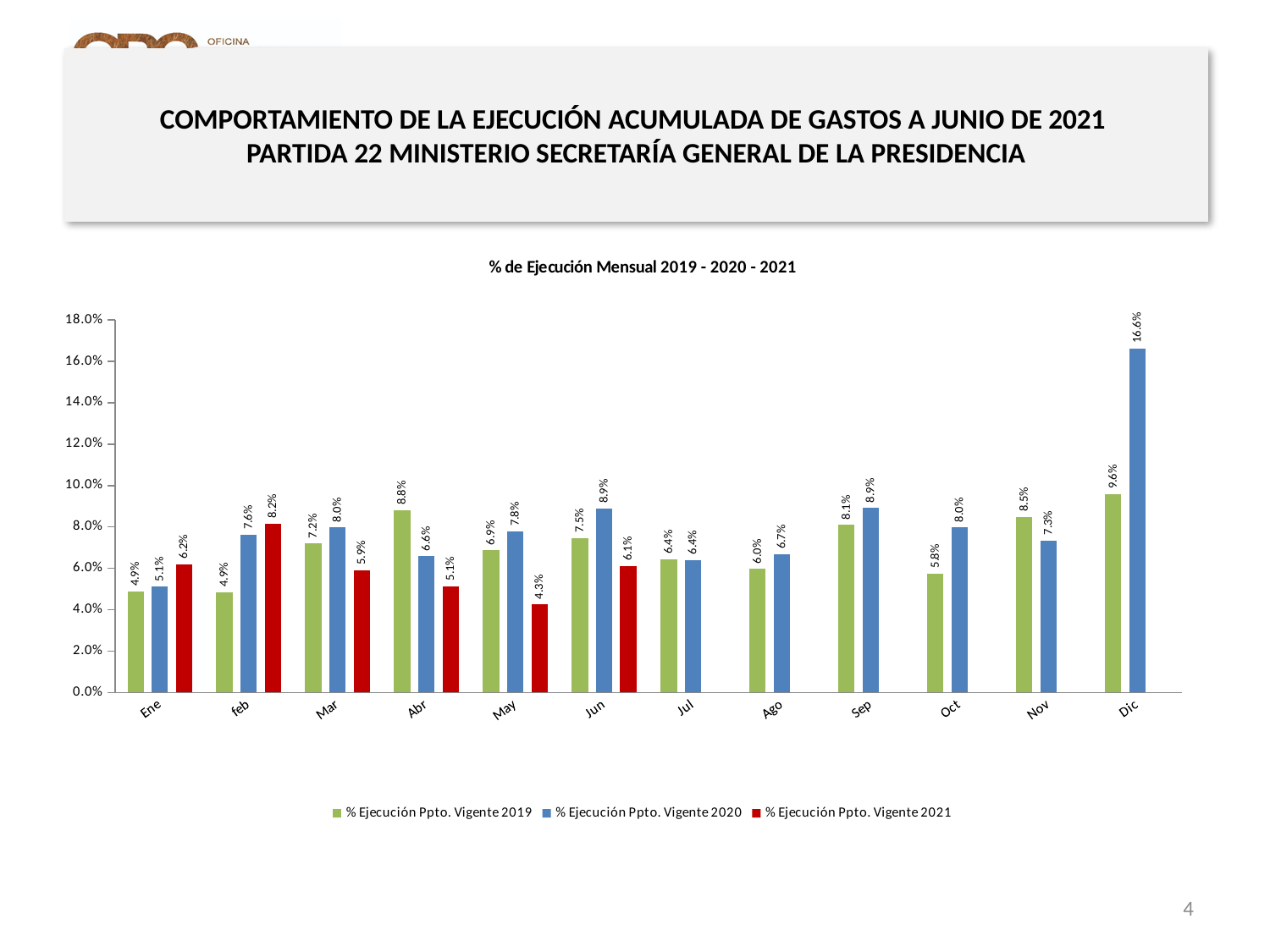
What is the % Ejecución Ppto. Vigente 2021 value for Abr? 5.1% What is the % Ejecución Ppto. Vigente 2020 value for Dic? 16.6% For Mar, which series is larger: % Ejecución Ppto. Vigente 2019 or % Ejecución Ppto. Vigente 2020? % Ejecución Ppto. Vigente 2020 What is the % Ejecución Ppto. Vigente 2019 value for Sep? 8.1% What kind of chart is shown on the slide? Bar chart Which month has the highest % Ejecución Ppto. Vigente 2021 value? feb Which month has the lowest % Ejecución Ppto. Vigente 2021 value? May How many series does the legend list? 3 What colour represents the % Ejecución Ppto. Vigente 2021 series? Red How many months are shown on the x axis? 12 Which month has the highest % Ejecución Ppto. Vigente 2019 value? Dic What is the difference between the 2020 and 2019 values for Dic? 7.0 percentage points